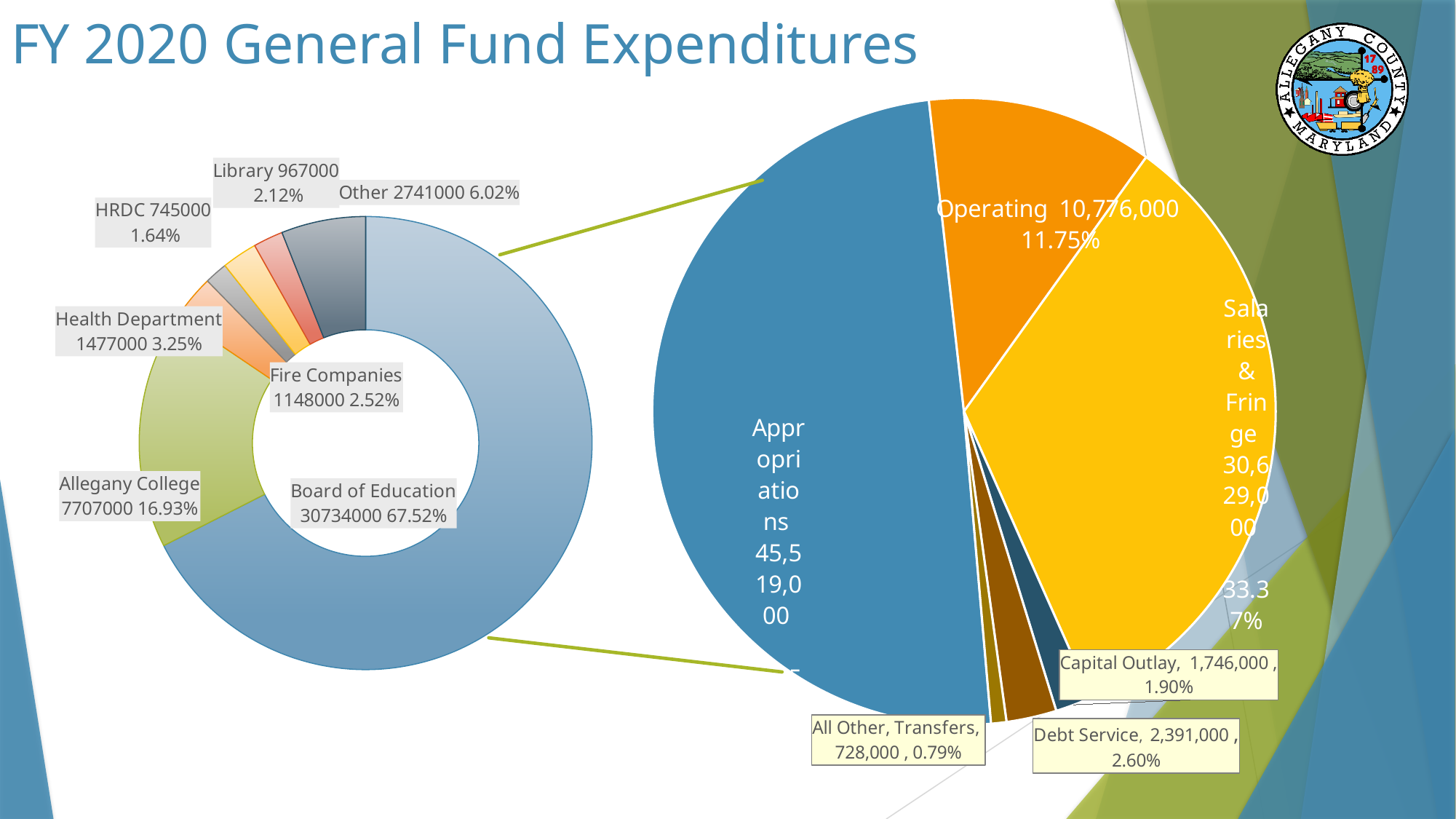
On the left doughnut chart, what is the value for Board of Education? 30734000 On the right pie chart, what is the value for Operating? 10,776,000 On the right pie chart, which slice is the smallest? All Other, Transfers On the left doughnut chart, which category has the largest value? Board of Education On the left doughnut chart, which category has the smallest value? HRDC What kind of chart is on the right side of the slide? Pie chart On the left doughnut chart, which is larger: Health Department or Fire Companies? Health Department On the right pie chart, what share of the pie is Salaries & Fringe? 33.37% On the left doughnut chart, what percentage is shown for Allegany College? 16.93% On the left doughnut chart, how many categories are shown? 7 On the right pie chart, what is the difference between the Operating value and the Debt Service value? 8,385,000 On the left doughnut chart, what is the difference between the Board of Education value and the Allegany College value? 23027000